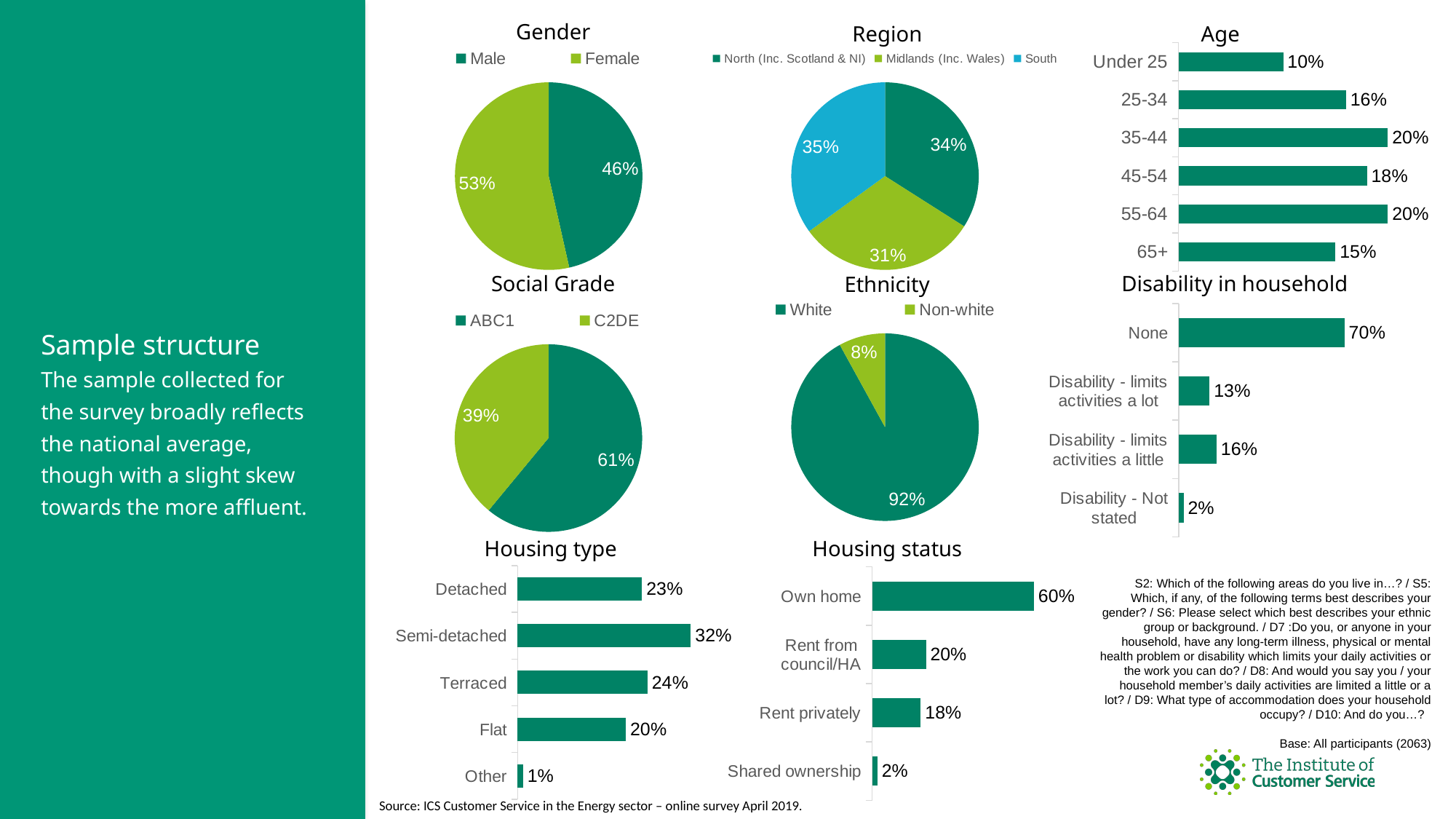
In the Region pie chart, which region has the largest share? South In the Age bar chart, what is the value for 25-34? 16% In the Social Grade pie chart, what is the difference between ABC1 and C2DE? 22% In the Housing type bar chart, which category has the highest value? Semi-detached In the Housing type bar chart, how many categories are shown? 5 In the Disability in household bar chart, what is the value for None? 70% What kind of chart is the Housing status chart? Bar chart In the Ethnicity pie chart, what share is Non-white? 8% How many series does the legend of the Region chart list? 3 In the Housing status bar chart, which is larger: Rent from council/HA or Rent privately? Rent from council/HA In the Age bar chart, which age group has the lowest value? Under 25 In the Gender pie chart, what percentage is Female? 53%